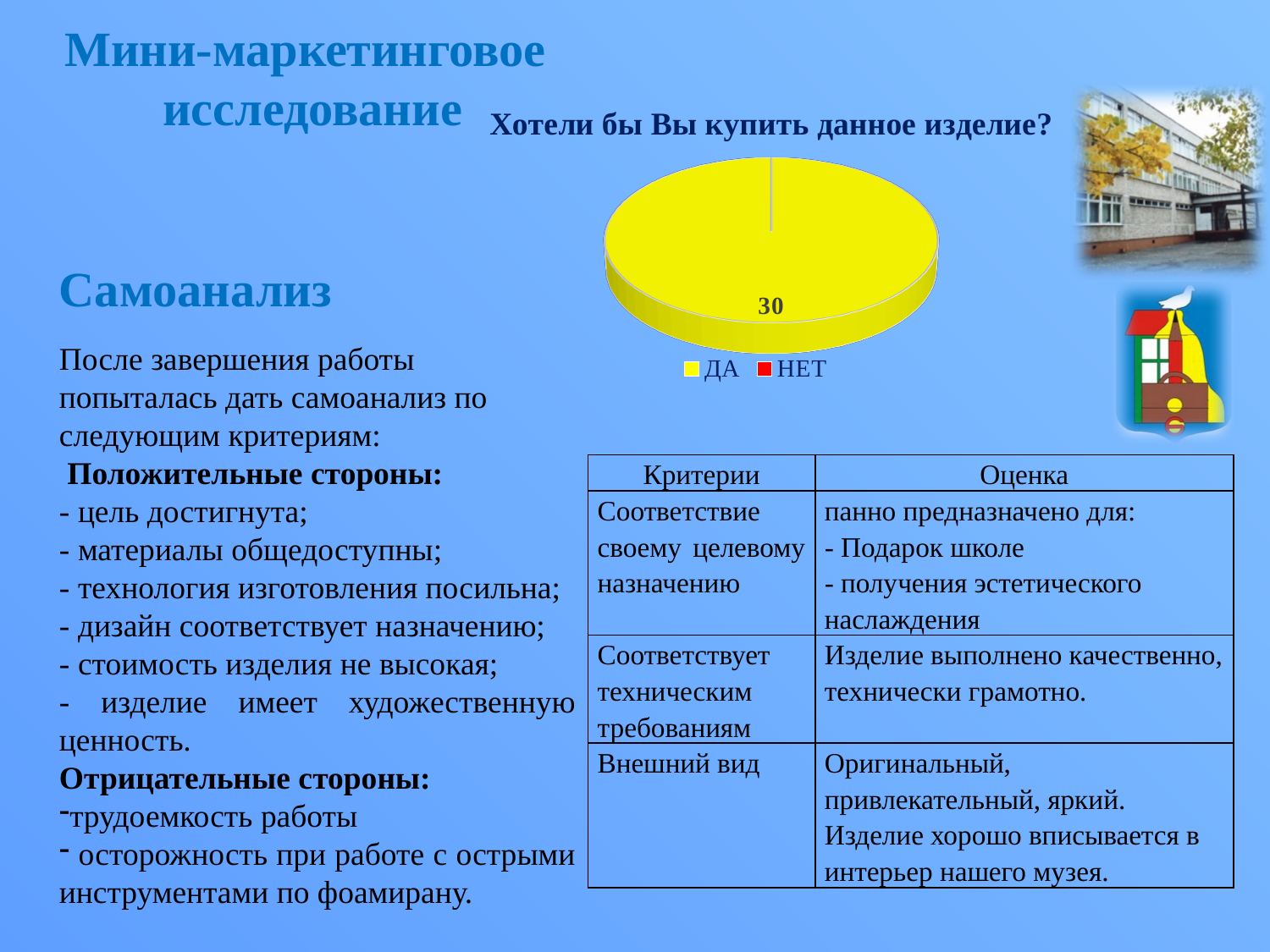
Which category has the smallest slice in the pie chart? НЕТ What value is printed on the pie chart for ДА? 30 What colour represents ДА in the pie chart? yellow Which category has the largest slice in the pie chart? ДА Which is larger in the pie chart, ДА or НЕТ? ДА What is the title of the pie chart? Хотели бы Вы купить данное изделие? Is the value for ДА in the pie chart greater or less than 20? greater How many entries does the legend of the pie chart list? 2 What kind of chart is shown on the slide? pie chart